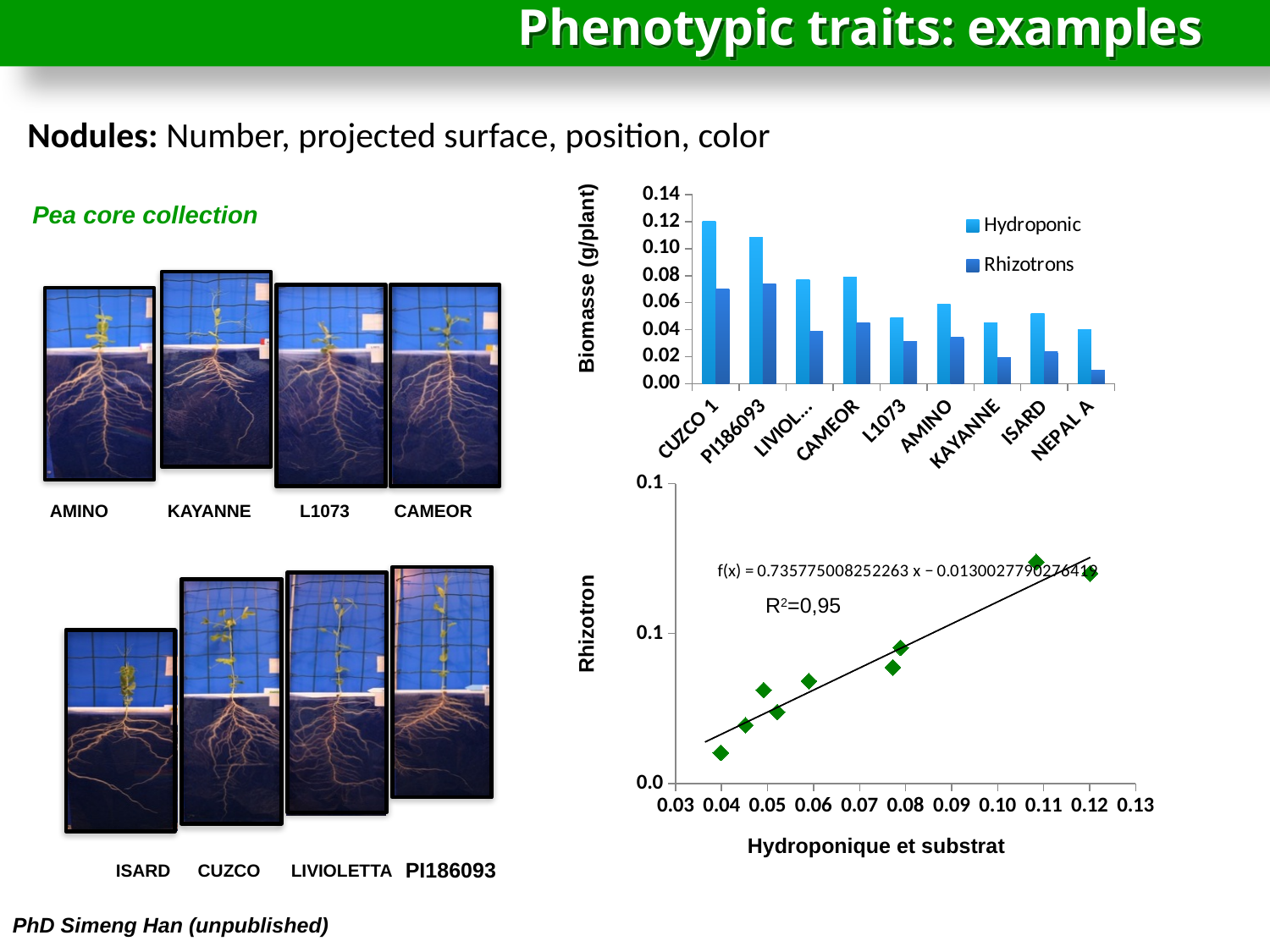
In the Biomasse (g/plant) bar chart, which is larger for CUZCO 1: the Hydroponic value or the Rhizotrons value? Hydroponic In the Biomasse (g/plant) bar chart, is the Hydroponic value for L1073 greater or less than 0.06? less In the Biomasse (g/plant) bar chart, is the Rhizotrons value for NEPAL A greater or less than 0.02? less What R² value is shown on the bottom chart on the right (Rhizotron vs Hydroponique et substrat)? 0,95 In the Biomasse (g/plant) bar chart, how many series does the legend list? 2 In the bottom chart on the right (Rhizotron vs Hydroponique et substrat), do the points rise or fall as the x value increases? rise In the Biomasse (g/plant) bar chart, which genotype has the lowest Rhizotrons biomass? NEPAL A What kind of chart is the top chart on the right (Biomasse g/plant)? bar chart In the Biomasse (g/plant) bar chart, is the Hydroponic value for CUZCO 1 greater or less than 0.10? greater In the Biomasse (g/plant) bar chart, how many genotype categories are shown on the x axis? 9 In the Biomasse (g/plant) bar chart, which genotype has the larger Hydroponic value, CUZCO 1 or NEPAL A? CUZCO 1 In the Biomasse (g/plant) bar chart, which genotype has the highest Hydroponic biomass? CUZCO 1